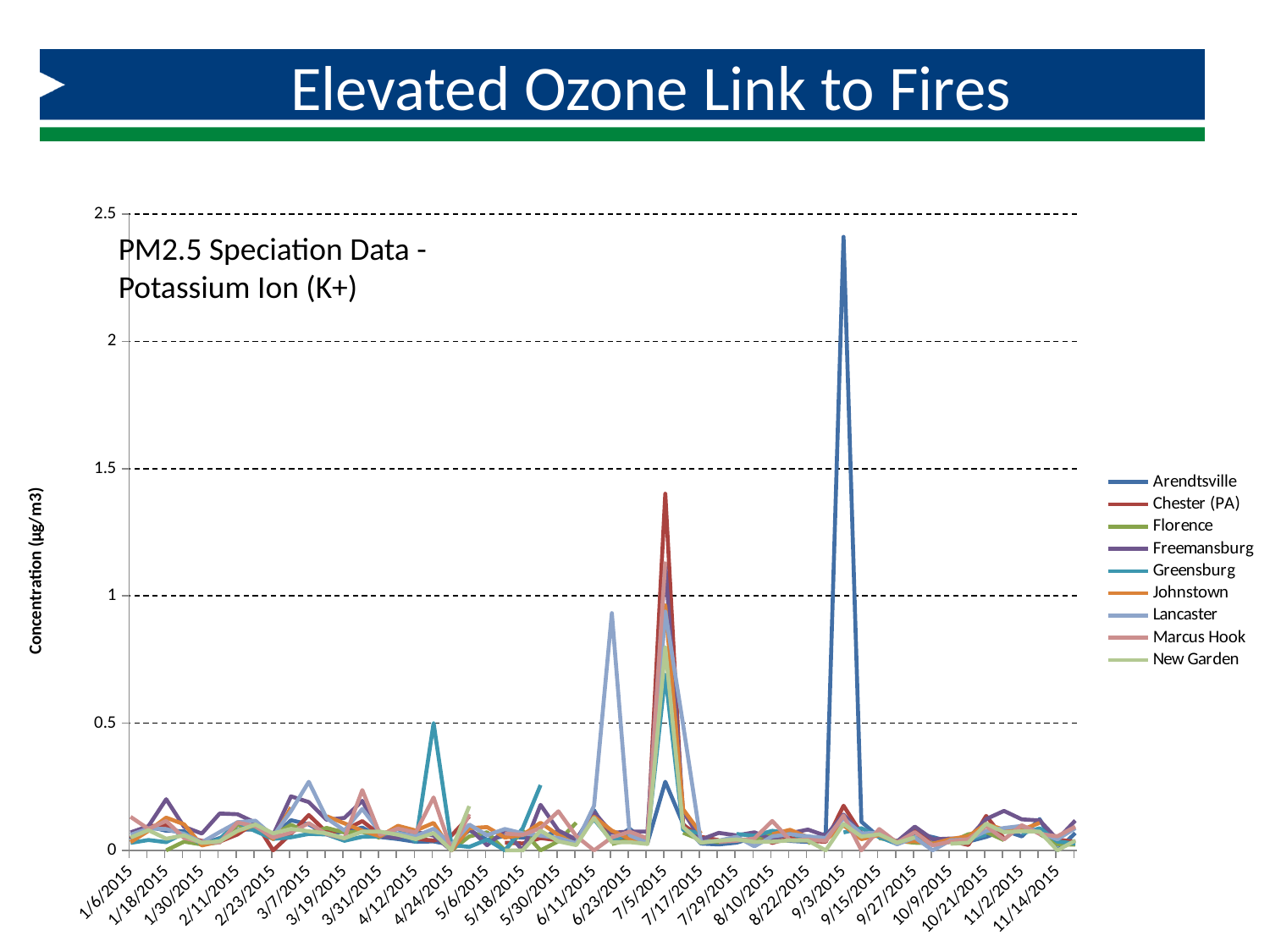
Is the peak value for Lancaster around 6/23/2015 greater or less than 1? less Is the value for Arendtsville around 7/5/2015 greater or less than 0.5? less What is the label on the vertical axis? Concentration (µg/m3) Which series reaches the highest value on the chart? Arendtsville Is the peak value for Lancaster around 6/23/2015 greater or less than 0.5? greater How many series does the legend list? 9 What is the title of the chart? PM2.5 Speciation Data - Potassium Ion (K+) What kind of chart is shown on the slide? Line chart Which is larger: the peak of Arendtsville around 9/3/2015 or the peak of Chester (PA) around 7/5/2015? Arendtsville What is the highest value shown on the vertical axis? 2.5